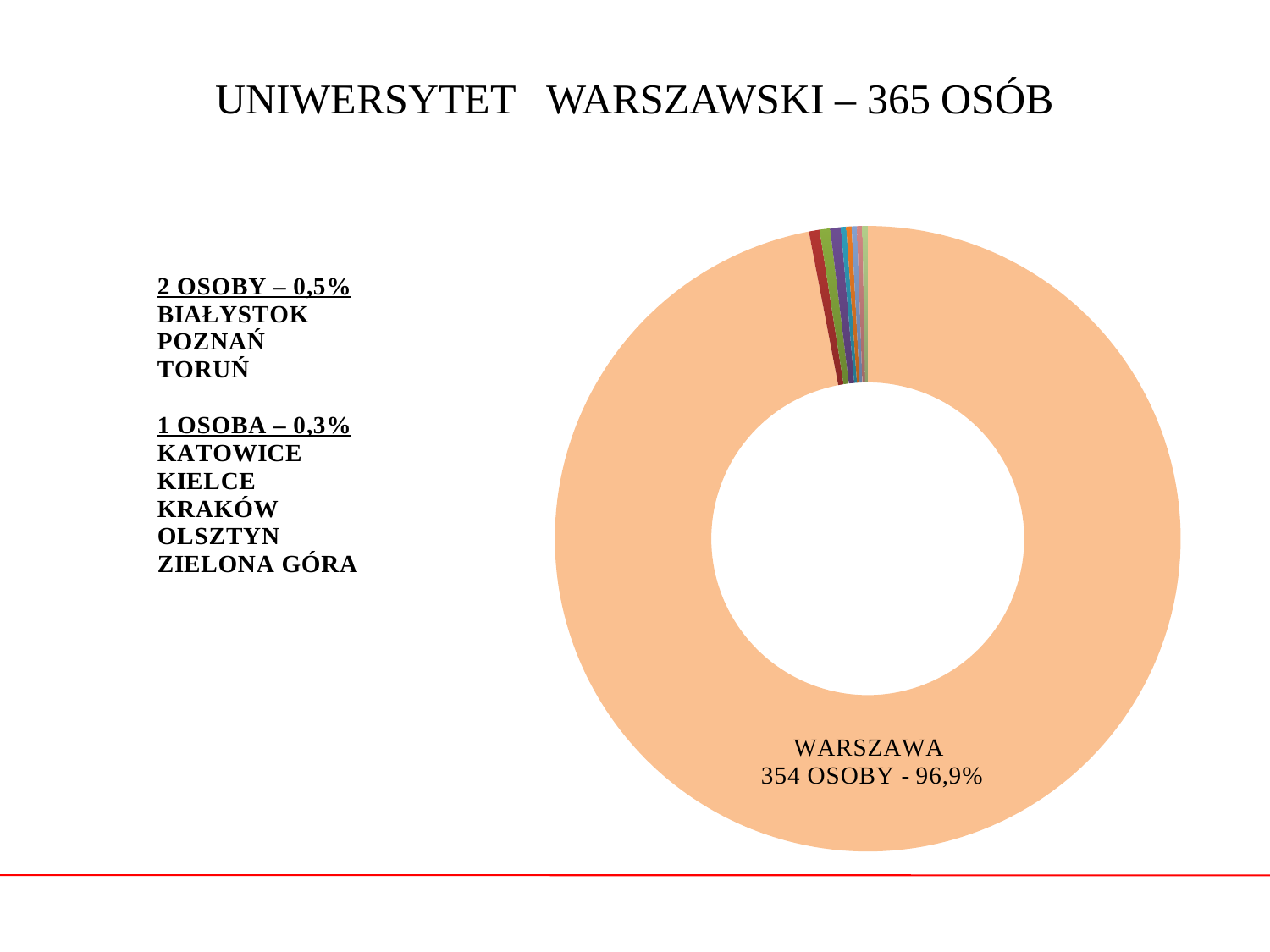
How many people does KATOWICE represent? 1 OSOBA Which category has the largest slice of the chart? WARSZAWA What is the total number of people represented in the chart? 365 OSÓB What share of the pie does OLSZTYN account for? 0,3% What share of the pie does WARSZAWA account for? 96,9% How many people does the WARSZAWA slice represent? 354 OSOBY What is the title of the chart on the slide? UNIWERSYTET WARSZAWSKI – 365 OSÓB What is the difference in number of people between WARSZAWA and TORUŃ? 352 What share of the pie does BIAŁYSTOK account for? 0,5% How many cities (categories) are represented in the chart? 9 What kind of chart is shown on the slide? pie chart (doughnut) Which is larger, the value for POZNAŃ or the value for KRAKÓW? POZNAŃ